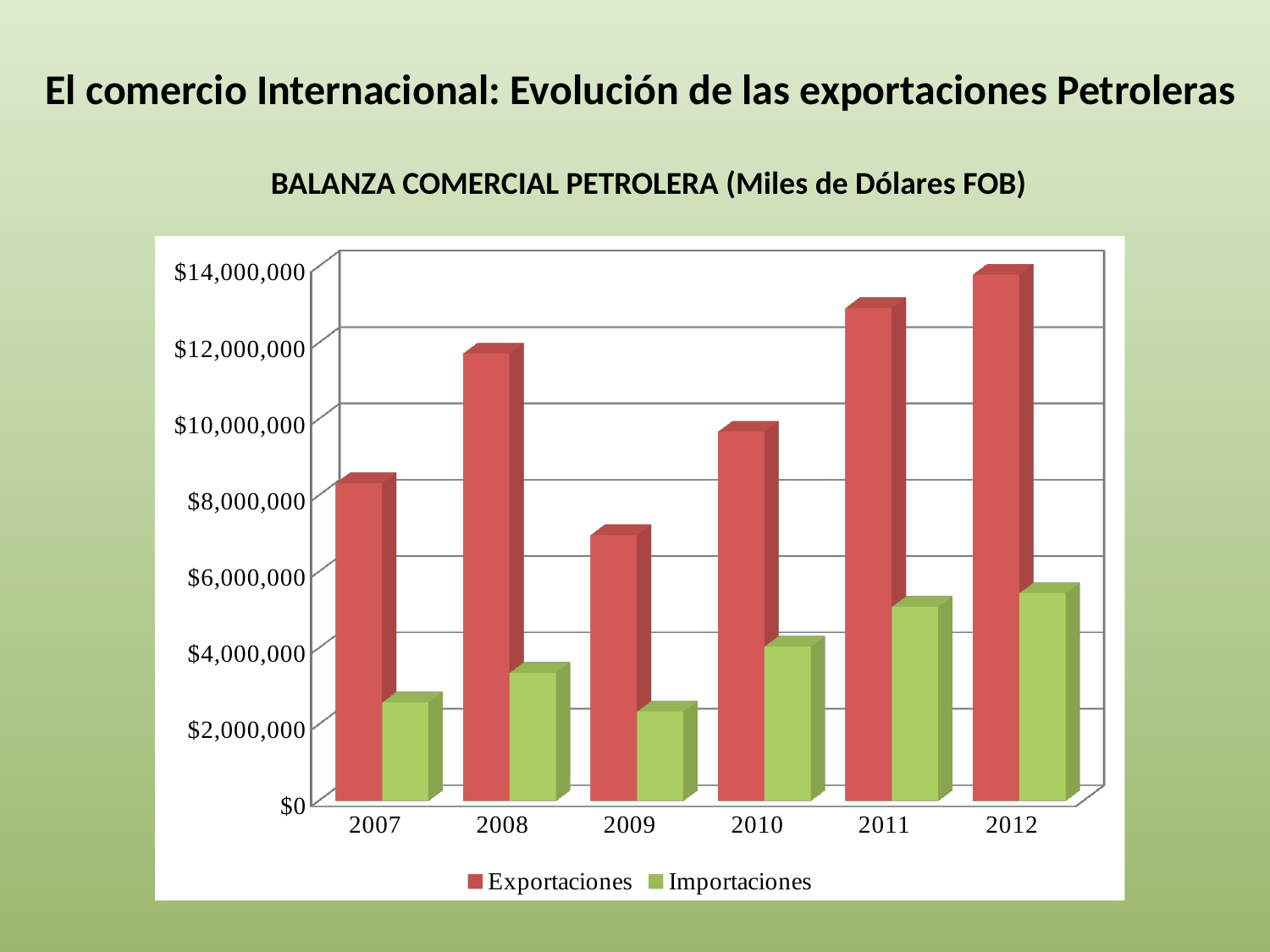
What is the title of the chart? BALANZA COMERCIAL PETROLERA (Miles de Dólares FOB) Is the Exportaciones value for 2008 greater or less than $10,000,000? greater Which is larger, the Exportaciones value for 2008 or for 2010? 2008 Which year has the lowest Exportaciones value? 2009 How many years are shown on the x axis? 6 Do the Exportaciones values rise or fall from 2009 to 2012? rise Which year has the highest Exportaciones value? 2012 Which year has the lowest Importaciones value? 2009 Is the Importaciones value for 2011 greater or less than $4,000,000? greater How many series does the legend list? 2 What kind of chart is shown on the slide? bar chart Is the Exportaciones value for 2009 greater or less than $8,000,000? less